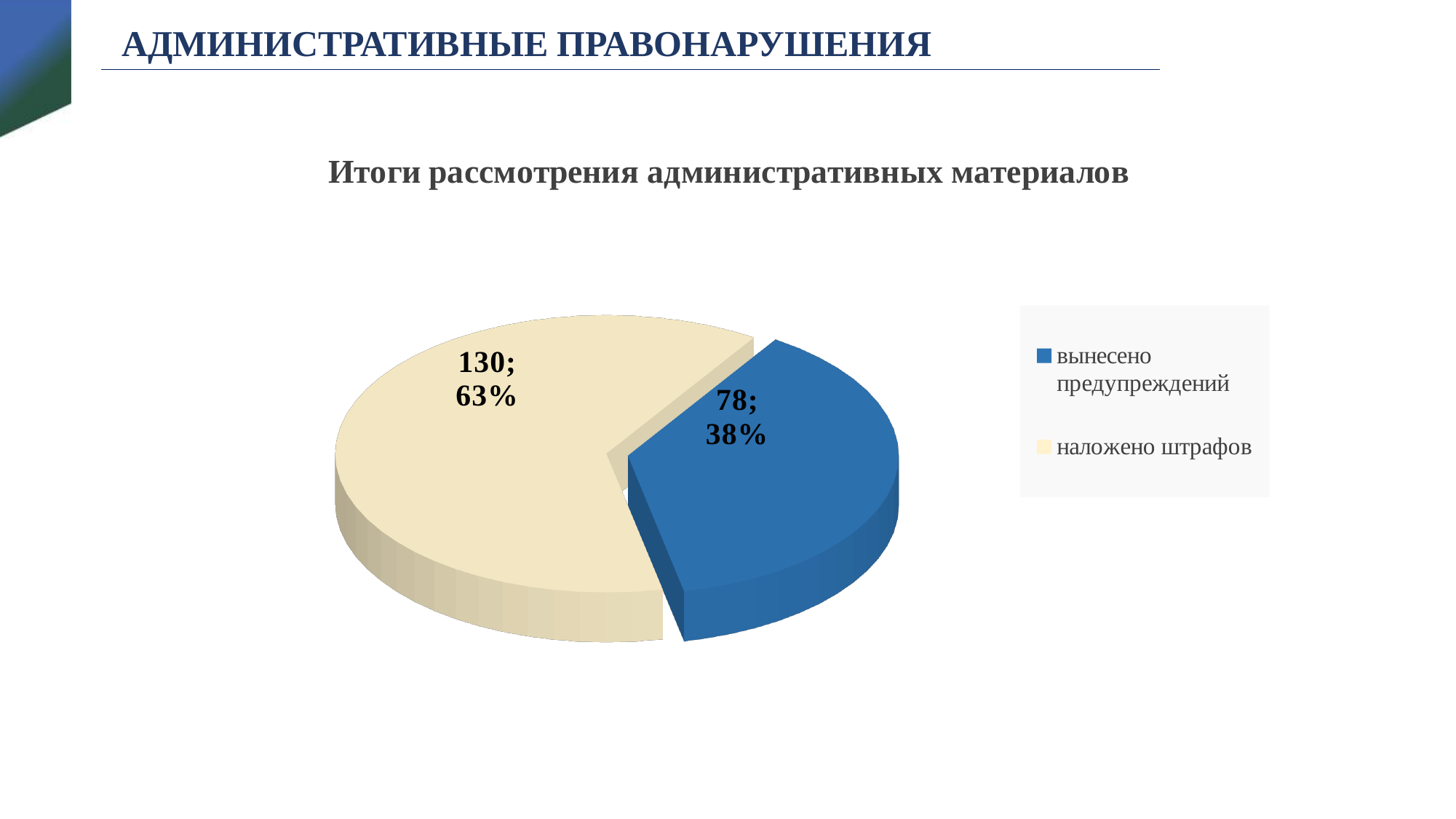
How many slices does the pie chart have? 2 What is the value for 'вынесено предупреждений'? 78 What is the title of the chart? Итоги рассмотрения административных материалов Which colour represents 'вынесено предупреждений' in the chart? blue How many entries does the legend list? 2 Which category has the smallest slice? вынесено предупреждений What share of the pie does 'наложено штрафов' represent? 63% What share of the pie does 'вынесено предупреждений' represent? 38% What is the difference between the values for 'наложено штрафов' and 'вынесено предупреждений'? 52 Which category has the largest slice? наложено штрафов What kind of chart is shown on the slide? pie chart What is the value for 'наложено штрафов'? 130